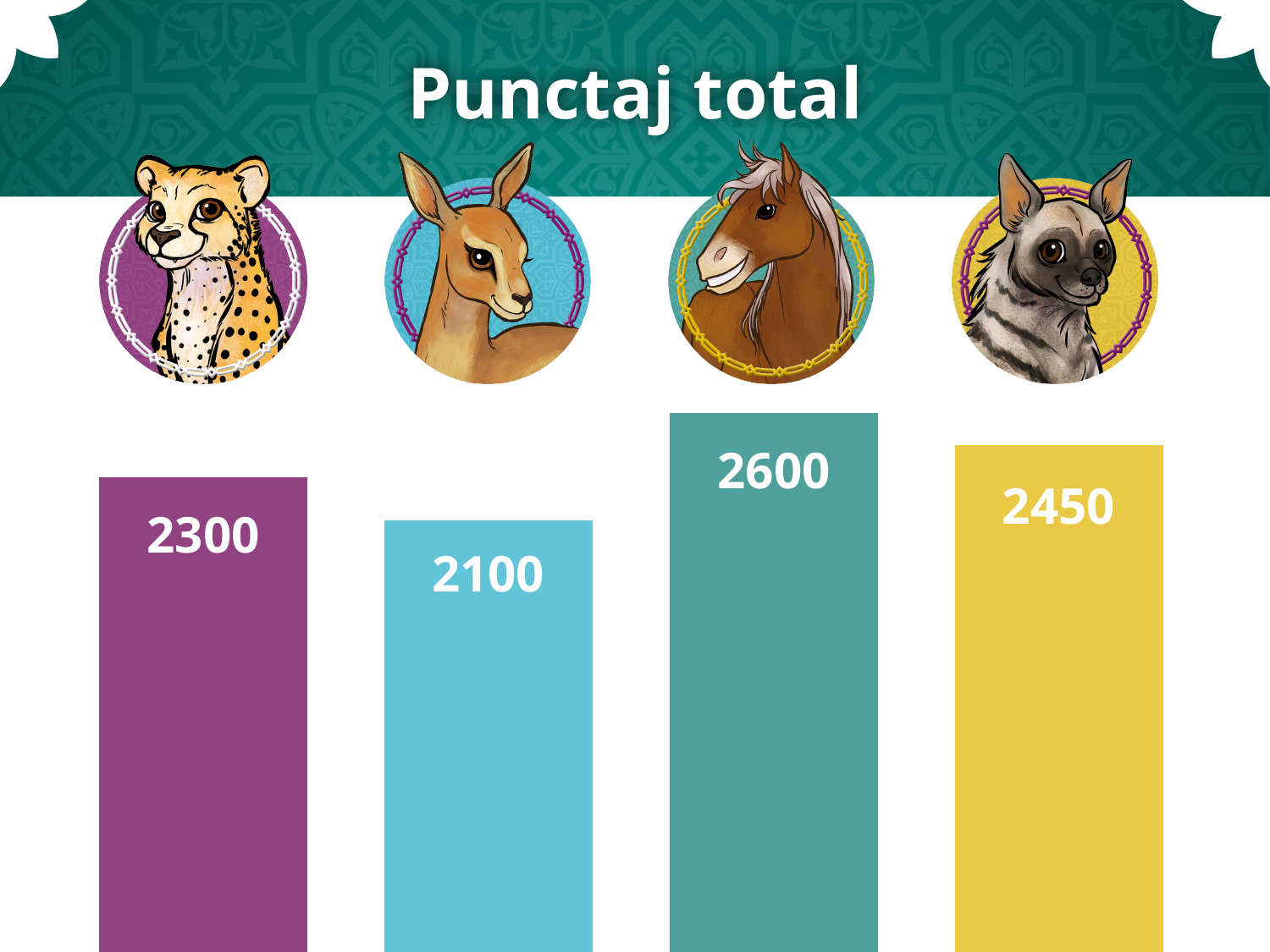
What is the value of the third bar from the left (the horse)? 2600 What is the title of the chart? Punctaj total What is the difference between the highest and lowest bar values? 500 What is the value of the first bar from the left (the cheetah)? 2300 Which bar has the highest value? The third bar (the horse), 2600 What is the difference between the fourth bar (hyena) and the first bar (cheetah)? 150 What is the value of the second bar from the left (the gazelle)? 2100 Which is larger, the value of the first bar (cheetah) or the fourth bar (hyena)? The fourth bar (hyena), 2450 How many bars are shown in the chart? 4 What kind of chart is shown on the slide? Bar chart Which bar has the lowest value? The second bar (the gazelle), 2100 What is the value of the fourth bar from the left (the hyena)? 2450